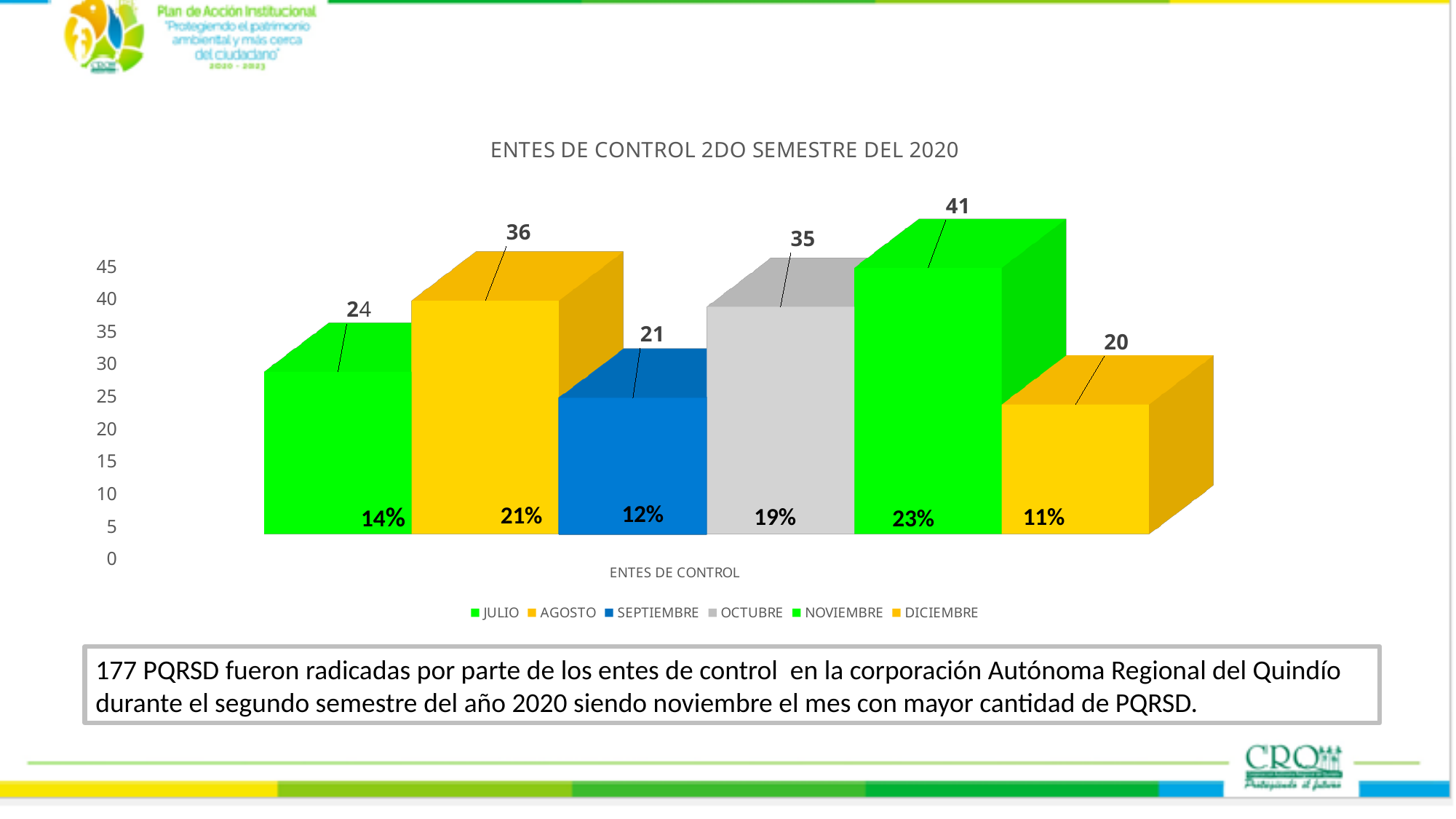
What is the value for SEPTIEMBRE in the chart? 21 Which month has the highest value in the chart? NOVIEMBRE What colour is the OCTUBRE bar in the chart? Grey What percentage is shown on the AGOSTO bar? 21% What is the difference between the values for AGOSTO and OCTUBRE? 1 Which is larger, the value for JULIO or the value for DICIEMBRE? JULIO What kind of chart is shown on the slide? Bar chart What is the title of the chart? ENTES DE CONTROL 2DO SEMESTRE DEL 2020 How many series does the legend list? 6 What is the value for NOVIEMBRE in the chart? 41 What is the difference between the values for NOVIEMBRE and JULIO? 17 Which month has the lowest value in the chart? DICIEMBRE